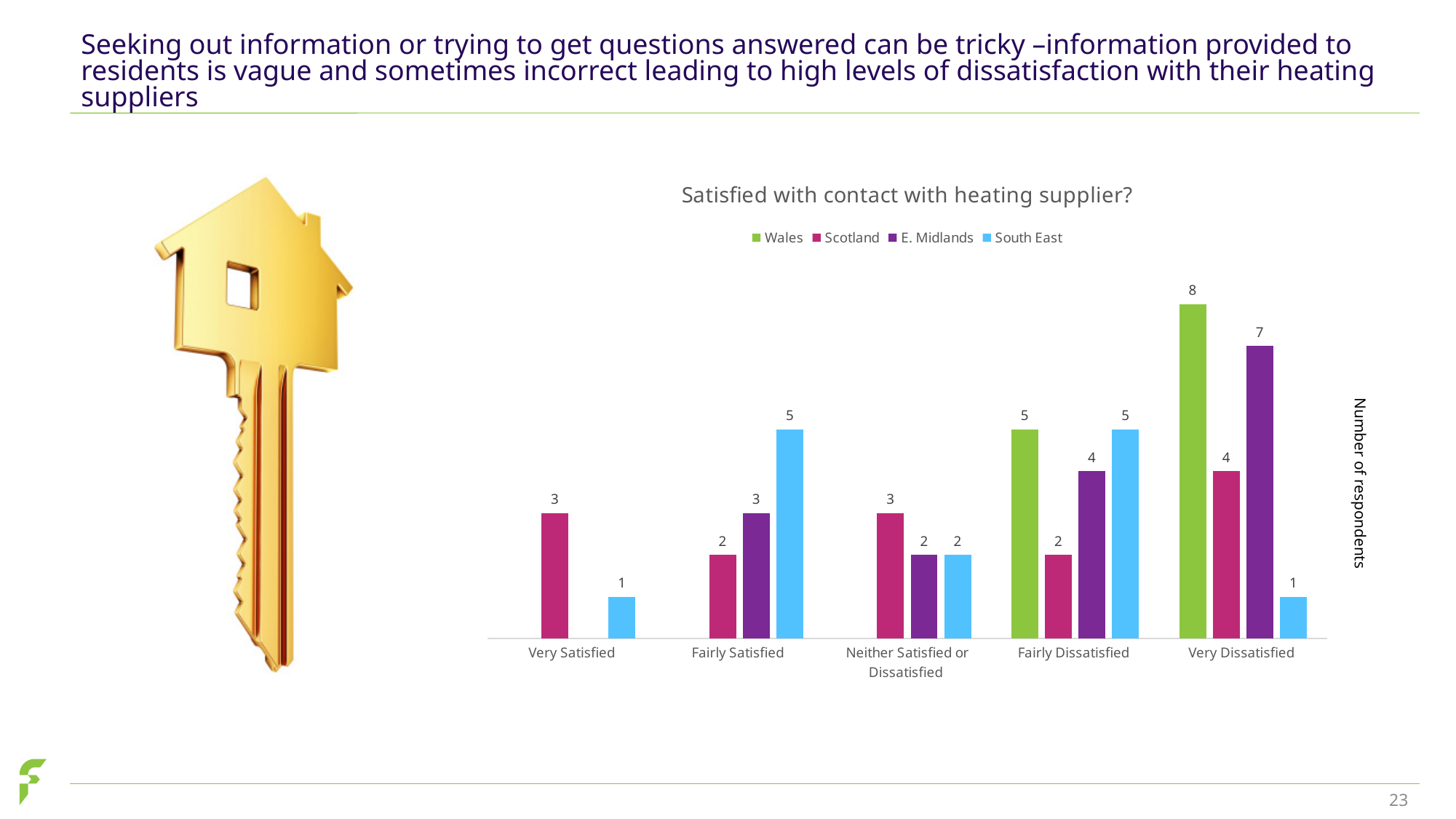
What kind of chart is shown on the slide? Bar chart What is the title of the chart? Satisfied with contact with heating supplier? Which region has the lowest value in the Very Dissatisfied category? South East What is the value for Wales in the Very Dissatisfied category? 8 What is the value for South East in the Fairly Satisfied category? 5 What is the difference between the Wales and Scotland values in the Very Dissatisfied category? 4 How many series does the legend list? 4 How many categories are shown on the x axis? 5 Which region has the highest value in the Very Dissatisfied category? Wales Which is larger: the E. Midlands value for Fairly Dissatisfied or the E. Midlands value for Fairly Satisfied? Fairly Dissatisfied What is the value for Scotland in the Very Satisfied category? 3 What is the value for E. Midlands in the Very Dissatisfied category? 7